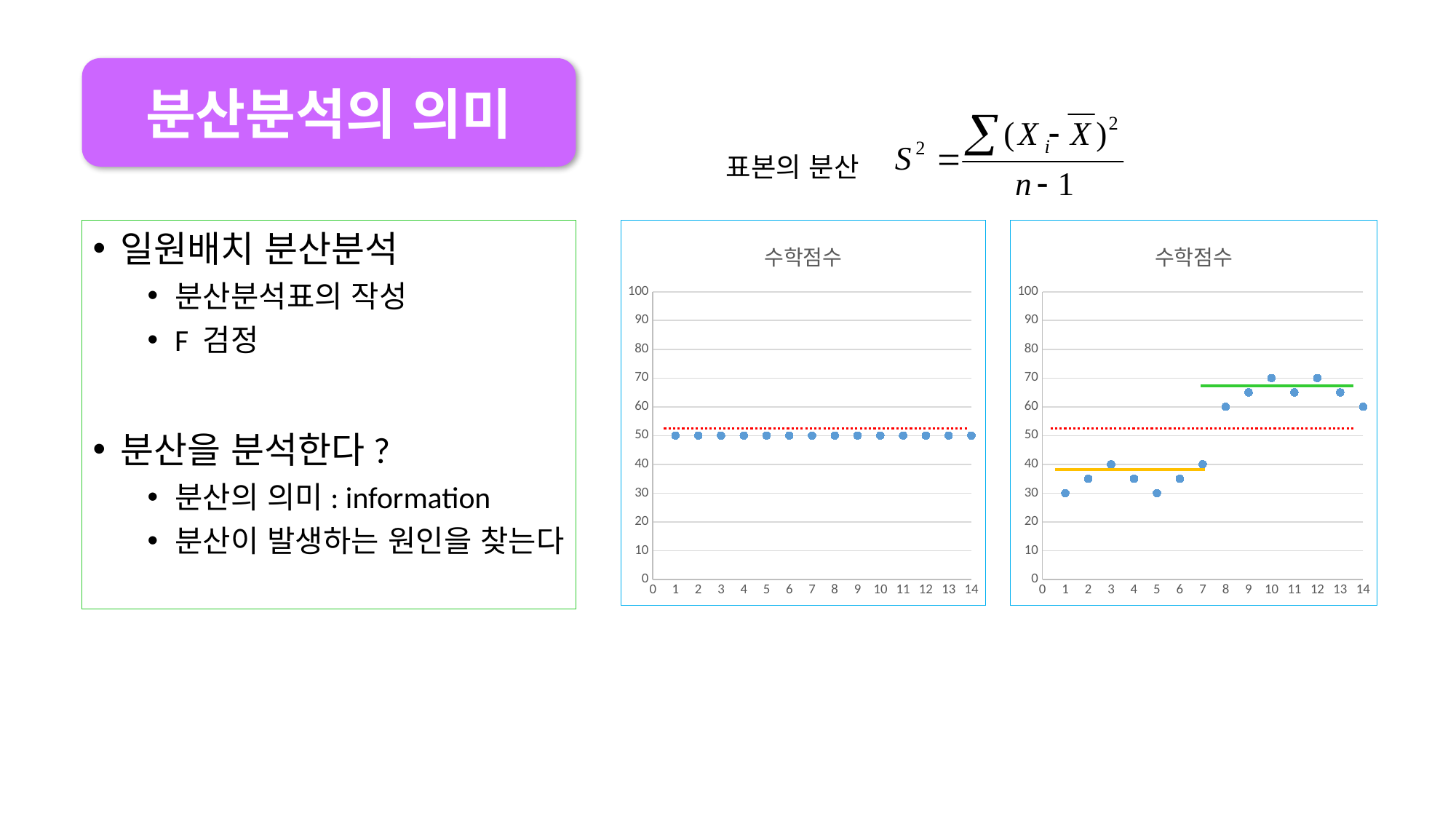
In the right chart, is the value at x = 9 greater or less than 60? greater What kind of chart is the left chart? scatter chart In the left chart, what is the value of the point at x = 5? 50 In the left chart, do the values rise, fall, or stay flat as x increases? stay flat What is the title shown on both charts? 수학점수 In the right chart, what is the value of the point at x = 8? 60 In the right chart, what is the difference between the value at x = 10 and the value at x = 1? 40 How many data points are plotted in the left chart? 14 In the right chart, what is the value of the point at x = 1? 30 In the right chart, which point has the larger value, x = 8 or x = 3? x = 8 In the right chart, what is the value of the point at x = 10? 70 In the right chart, is the value at x = 2 greater or less than 40? less